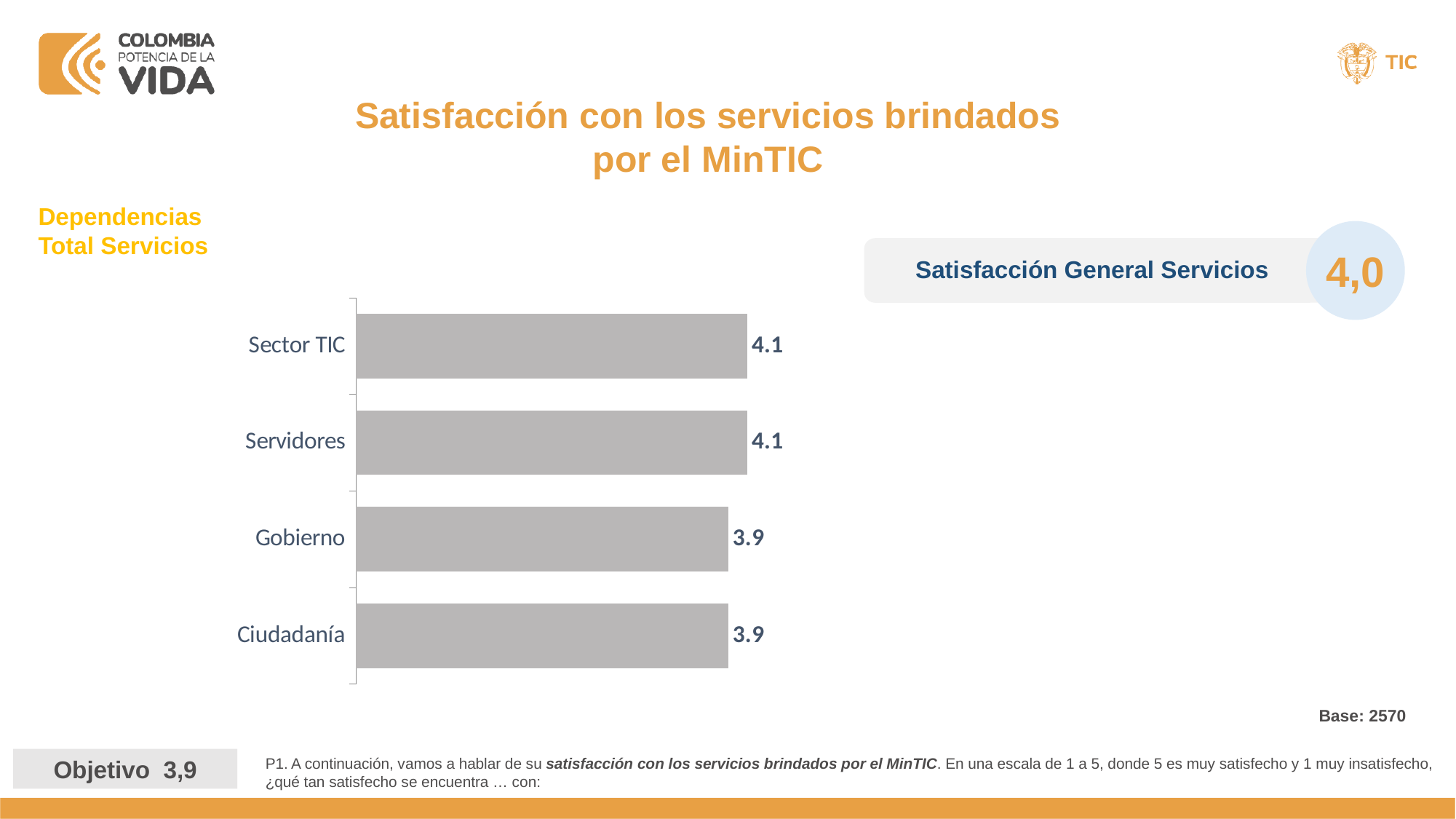
What is the satisfaction value shown for Sector TIC? 4.1 How many categories are plotted in the bar chart? 4 What is the Objetivo value shown at the bottom of the slide? 3,9 What is the satisfaction value shown for Servidores? 4.1 What is the difference between the values for Servidores and Gobierno? 0.2 Which has the larger value, Sector TIC or Gobierno? Sector TIC What is the value shown for Satisfacción General Servicios on the slide? 4,0 What is the difference between the values for Sector TIC and Ciudadanía? 0.2 What kind of chart is shown on the slide? Bar chart Which has the larger value, Servidores or Ciudadanía? Servidores What is the satisfaction value shown for Ciudadanía? 3.9 What is the satisfaction value shown for Gobierno? 3.9